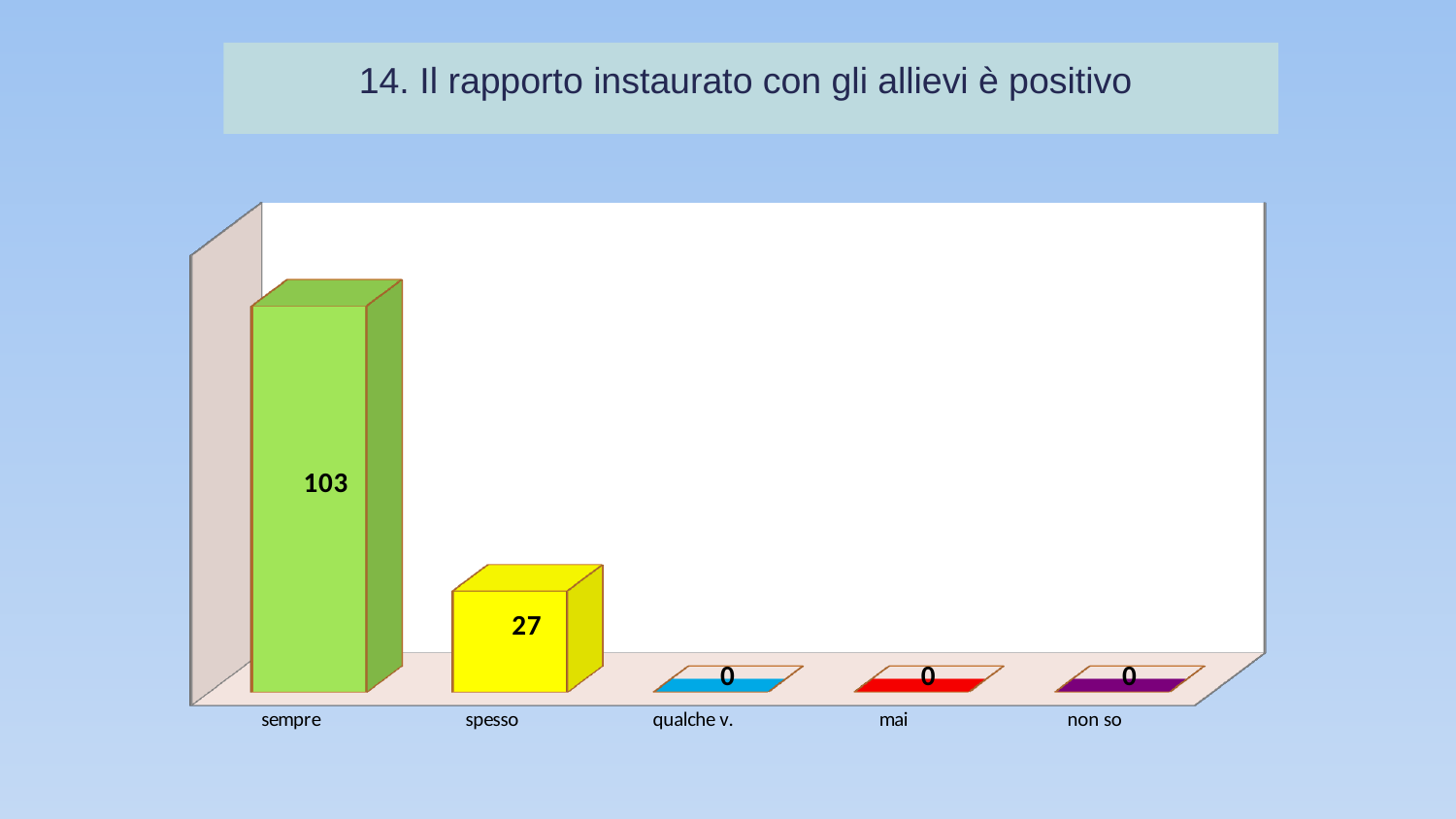
Which category has the highest value? sempre What is the value for "mai"? 0 Which is larger, the value for "spesso" or the value for "non so"? spesso What kind of chart is shown on the slide? bar chart What is the value for "sempre"? 103 What is the value for "qualche v."? 0 What is the total of all the values shown in the chart? 130 What is the difference between the values for "sempre" and "spesso"? 76 What is the value for "spesso"? 27 How many categories are shown on the x axis? 5 Do the values rise or fall from left to right along the x axis? fall What is the title of the slide? 14. Il rapporto instaurato con gli allievi è positivo